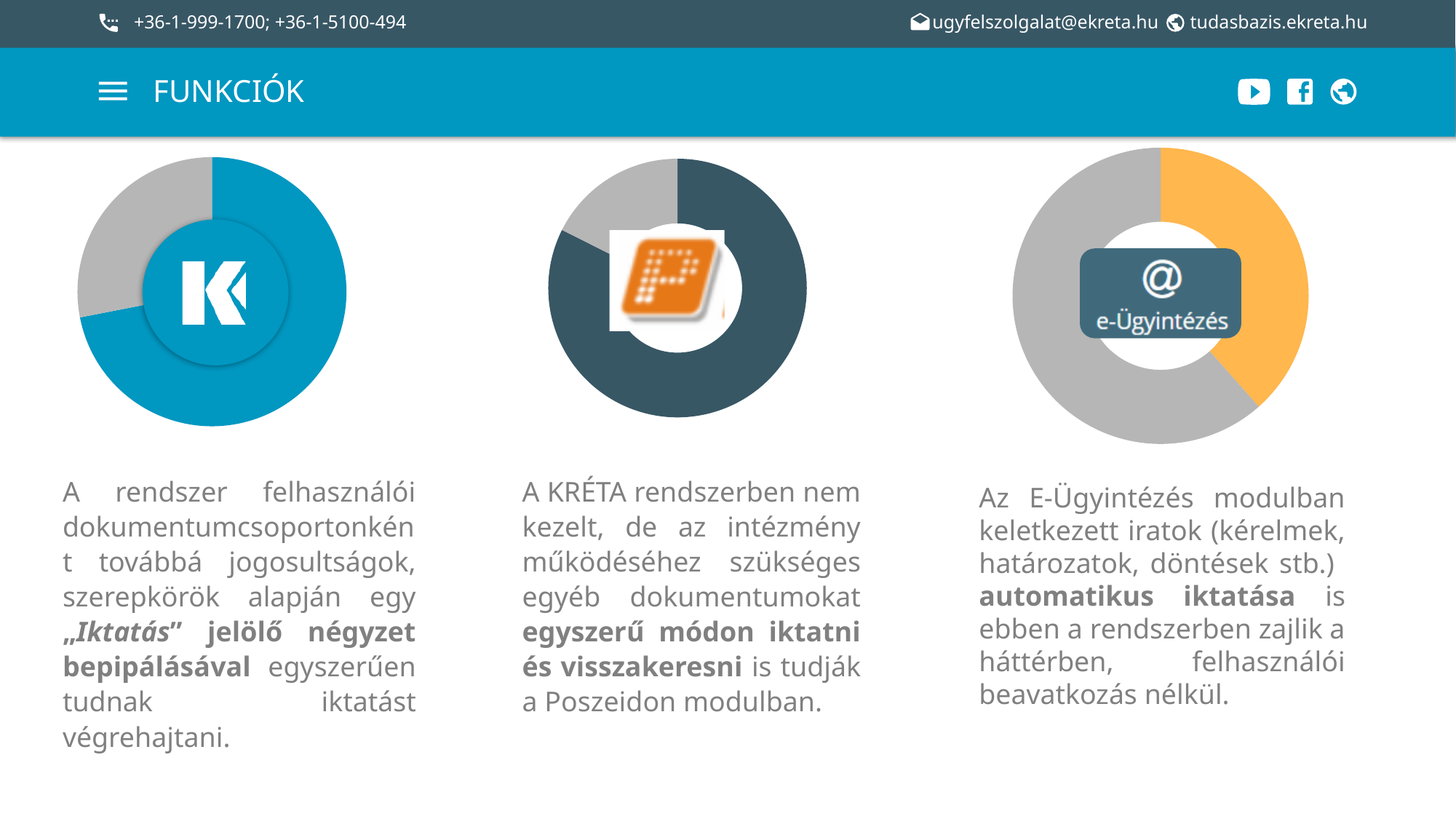
How many slices does the left chart with the K logo have? 2 How many slices does the right chart with the e-Ügyintézés label have? 2 In the left chart with the K logo, which slice is larger, the blue one or the grey one? the blue one What colour is the larger slice of the right chart with the e-Ügyintézés label? grey How many slices does the middle chart with the P logo have? 2 What kind of chart is the left chart with the K logo? doughnut chart In the right chart with the e-Ügyintézés label, which slice is larger, the orange one or the grey one? the grey one What kind of chart is the right chart with the e-Ügyintézés label? doughnut chart In the middle chart with the P logo, which slice is larger, the dark teal one or the grey one? the dark teal one How many pie charts are shown on the slide? 3